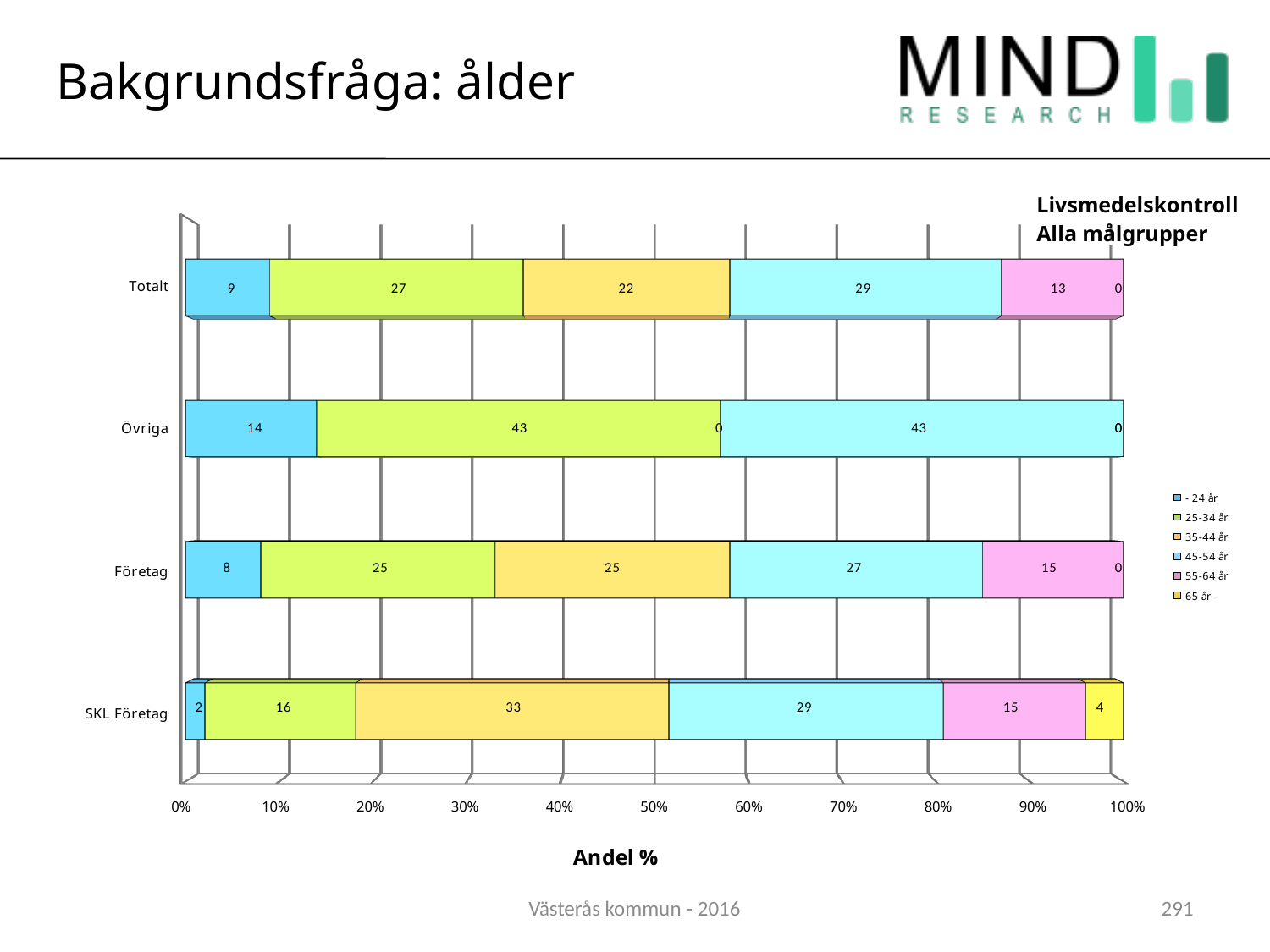
What kind of chart is shown on the slide? Stacked bar chart How many categories are shown on the vertical axis? 4 Which category has the lowest value for the - 24 år series? SKL Företag Which is larger: the 25-34 år segment for Totalt or for Företag? Totalt What is the difference between the 45-54 år and - 24 år segments of the Totalt bar? 20 How many series does the legend list? 6 What is the value for the 25-34 år segment of the Totalt bar? 27 What is the value for the - 24 år segment of the Övriga bar? 14 What is the value for the 35-44 år segment of the SKL Företag bar? 33 What is the value for the 65 år - segment of the SKL Företag bar? 4 What is the value for the 55-64 år segment of the Företag bar? 15 Which category has the highest value for the 35-44 år series? SKL Företag